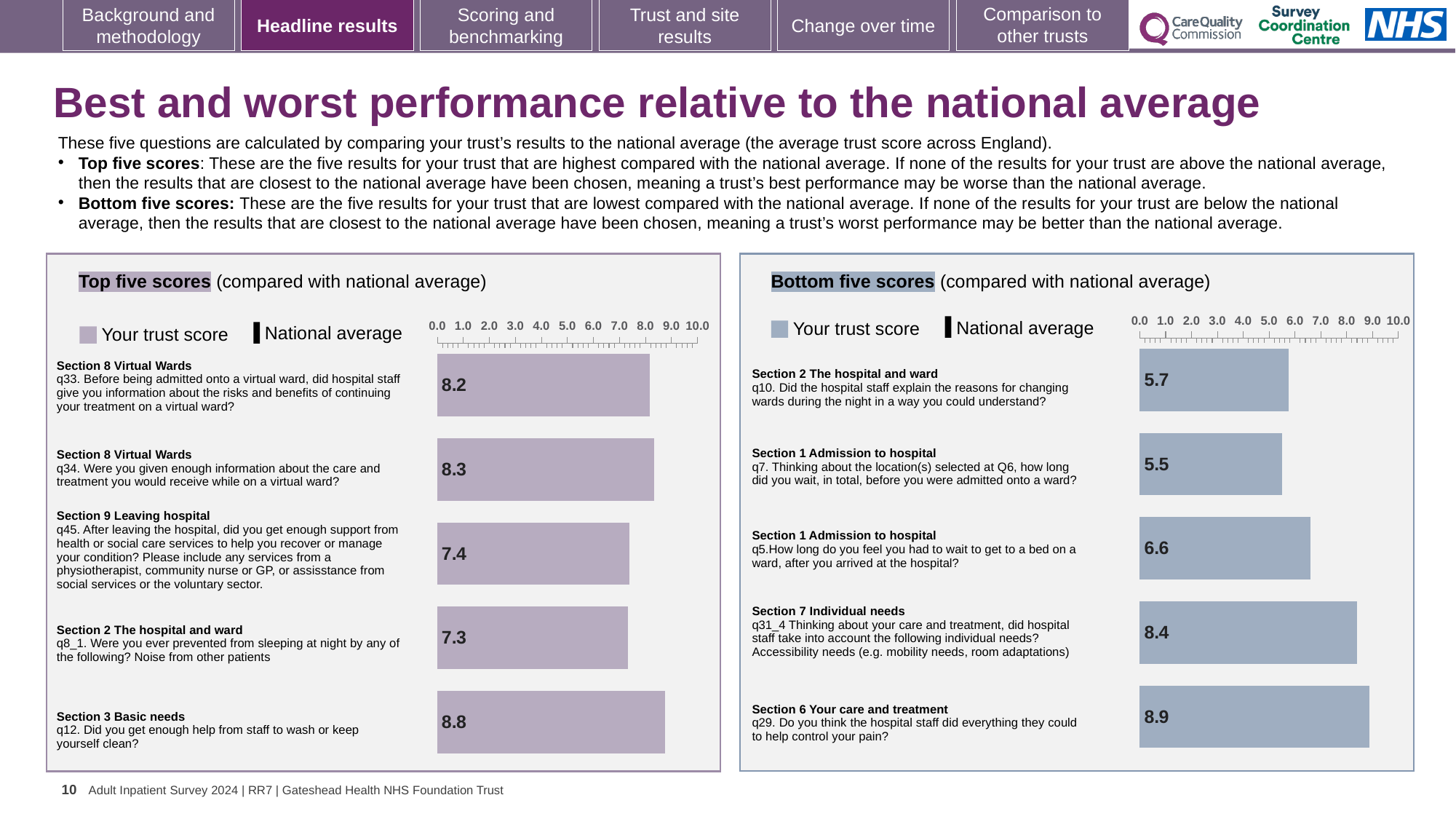
How many entries does the legend of the Top five scores chart list? 2 In the Top five scores chart, what is the difference between the trust scores for q34 and q8_1? 1.0 In the Bottom five scores chart, what is the trust score for q7 about how long you waited before being admitted onto a ward? 5.5 In the Bottom five scores chart, which question has the lowest trust score? q7. Thinking about the location(s) selected at Q6, how long did you wait, in total, before you were admitted onto a ward? In the Top five scores chart, which question has the highest trust score? q12. Did you get enough help from staff to wash or keep yourself clean? How many questions are shown in the Bottom five scores chart? 5 In the Bottom five scores chart, what is the trust score for q29 about staff doing everything they could to help control your pain? 8.9 In the Bottom five scores chart, what is the difference between the trust scores for q29 and q10? 3.2 What type of chart is used for the Top five scores? Bar chart In the Top five scores chart, what is the trust score for q45 about support from health or social care services after leaving hospital? 7.4 In the Top five scores chart, what is the trust score for q12 (Did you get enough help from staff to wash or keep yourself clean?)? 8.8 In the Bottom five scores chart, which has the larger trust score: q5 or q31_4? q31_4